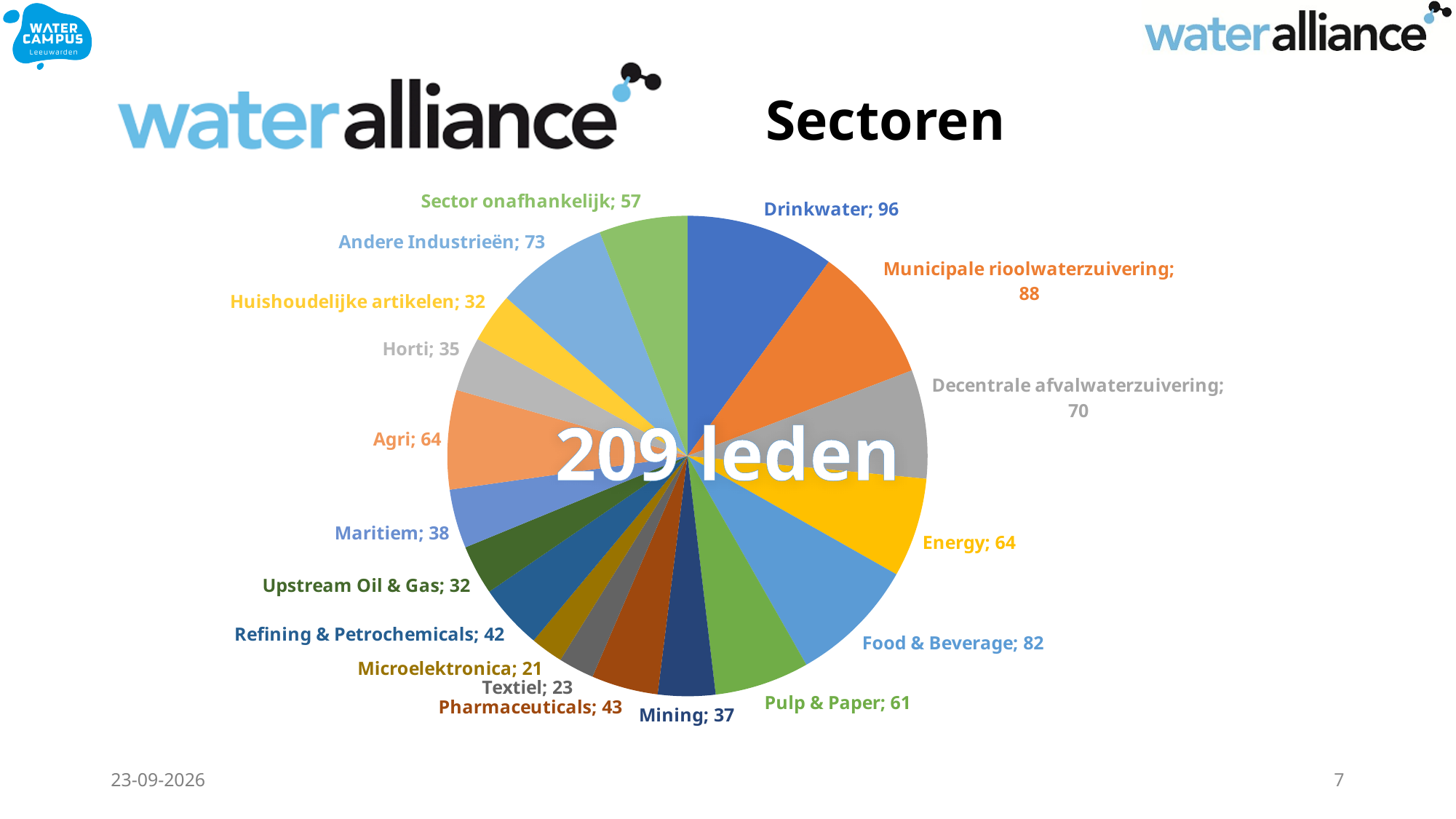
Which sector has the lowest value in the pie chart? Microelektronica What kind of chart is shown on the slide? Pie chart What text is displayed in the centre of the pie chart? 209 leden What value is shown for Microelektronica? 21 Which sector has the highest value in the pie chart? Drinkwater What value is shown for Drinkwater in the pie chart? 96 What value is shown for Pulp & Paper? 61 Which is larger, the value for Agri or the value for Maritiem? Agri How many sectors are shown in the pie chart? 18 What is the difference between the values for Food & Beverage and Andere Industrieën? 9 What value is shown for Municipale rioolwaterzuivering? 88 What is the difference between the values for Drinkwater and Municipale rioolwaterzuivering? 8